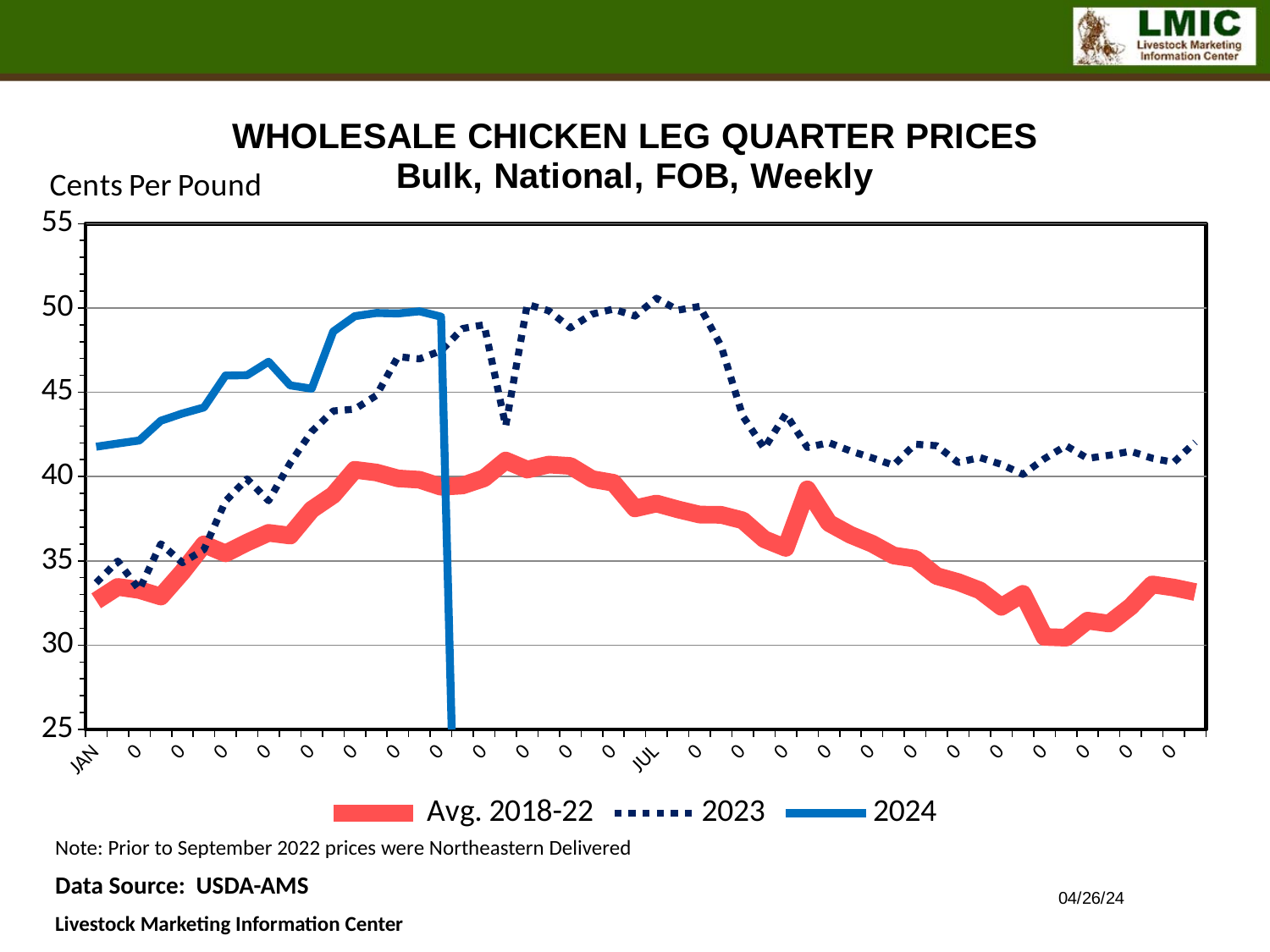
In January, which series has the higher value, 2024 or 2023? 2024 What is the title of the chart? WHOLESALE CHICKEN LEG QUARTER PRICES Bulk, National, FOB, Weekly Is the value of the 2023 series in January greater or less than 35? less What kind of chart is shown on the slide? Line chart Is the value of the 2024 series in January greater or less than 40? greater Is the value of the Avg. 2018-22 series in July greater or less than 40? less How many series does the legend list? 3 Does the 2024 series generally rise or fall from January to its last plotted week? rise Which series has the lowest values for most of the year? Avg. 2018-22 What unit is shown on the vertical axis of the chart? Cents Per Pound